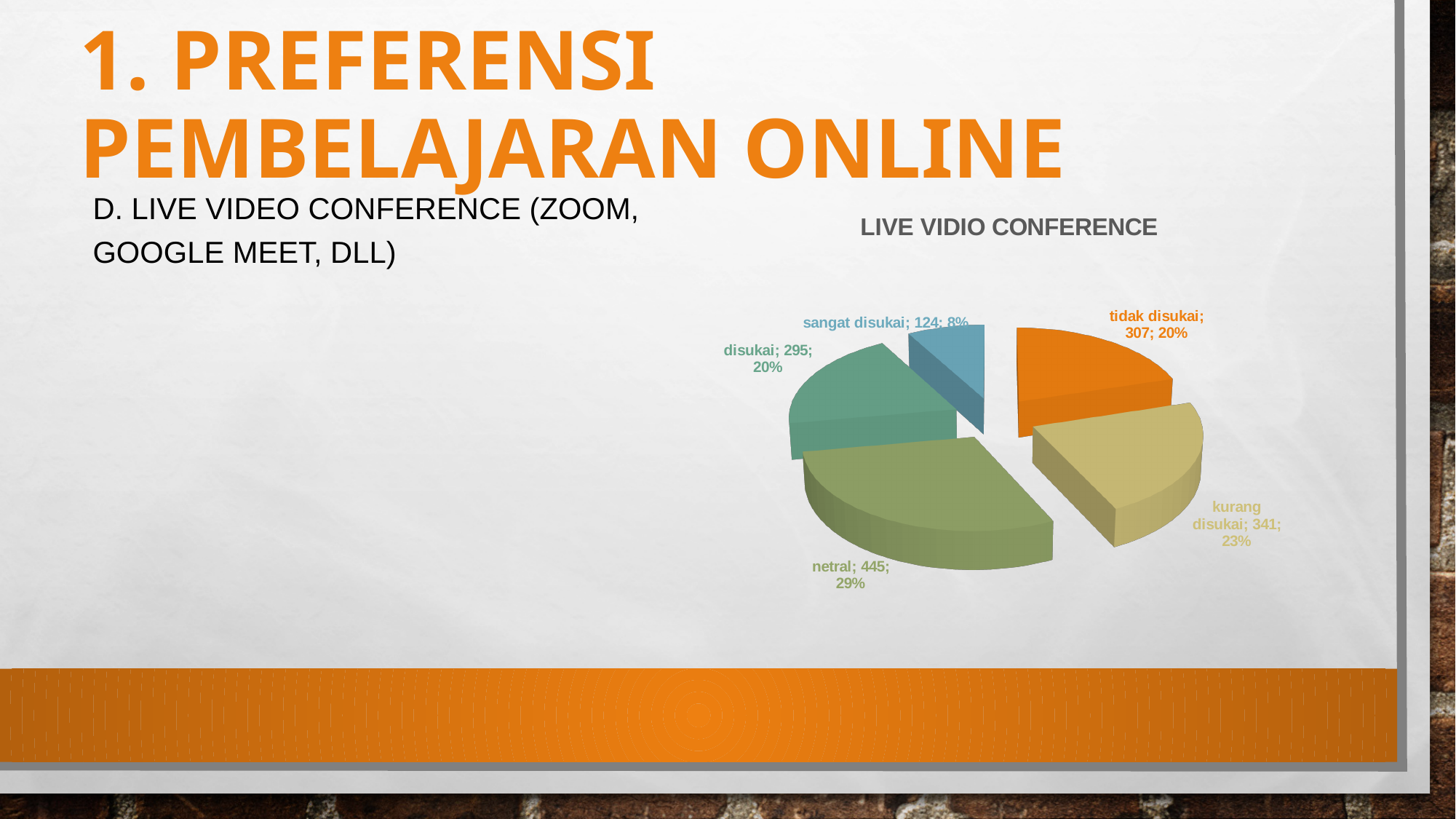
Which category has the smallest slice? sangat disukai What is the value for netral? 445 What is the value for sangat disukai? 124 What kind of chart is shown on the slide? pie chart Which category has the largest slice? netral What percentage share does netral have? 29% What percentage share does tidak disukai have? 20% What is the difference between the values for kurang disukai and tidak disukai? 34 Which is larger, the value for disukai or the value for tidak disukai? tidak disukai What is the title of the chart? LIVE VIDIO CONFERENCE What is the value for kurang disukai? 341 How many slices does the pie chart have? 5